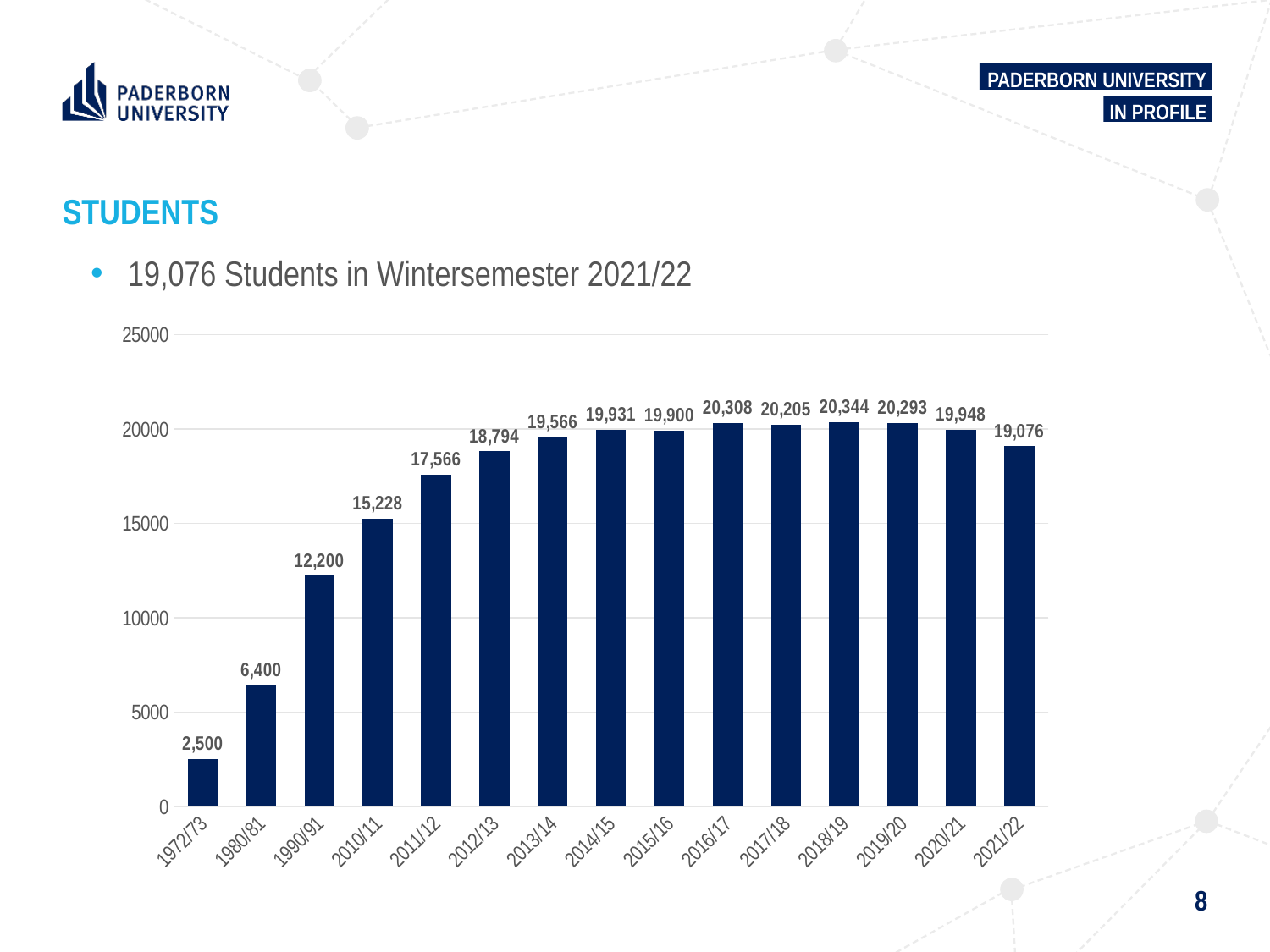
Is the value for 1990/91 greater or less than 10000? greater Which year has the highest number of students? 2018/19 How many students were there in 2021/22 according to the chart? 19,076 What is the difference between the values for 1980/81 and 1972/73? 3,900 Which year has the lowest number of students? 1972/73 How many years (bars) are shown in the chart? 15 What is the value shown for 2016/17? 20,308 Do the values rise or fall from 1972/73 to 2018/19? rise What is the value shown for 1990/91? 12,200 What is the difference between the values for 2020/21 and 2021/22? 872 What kind of chart is shown on the slide? bar chart Which is larger, the value for 2016/17 or the value for 2017/18? 2016/17